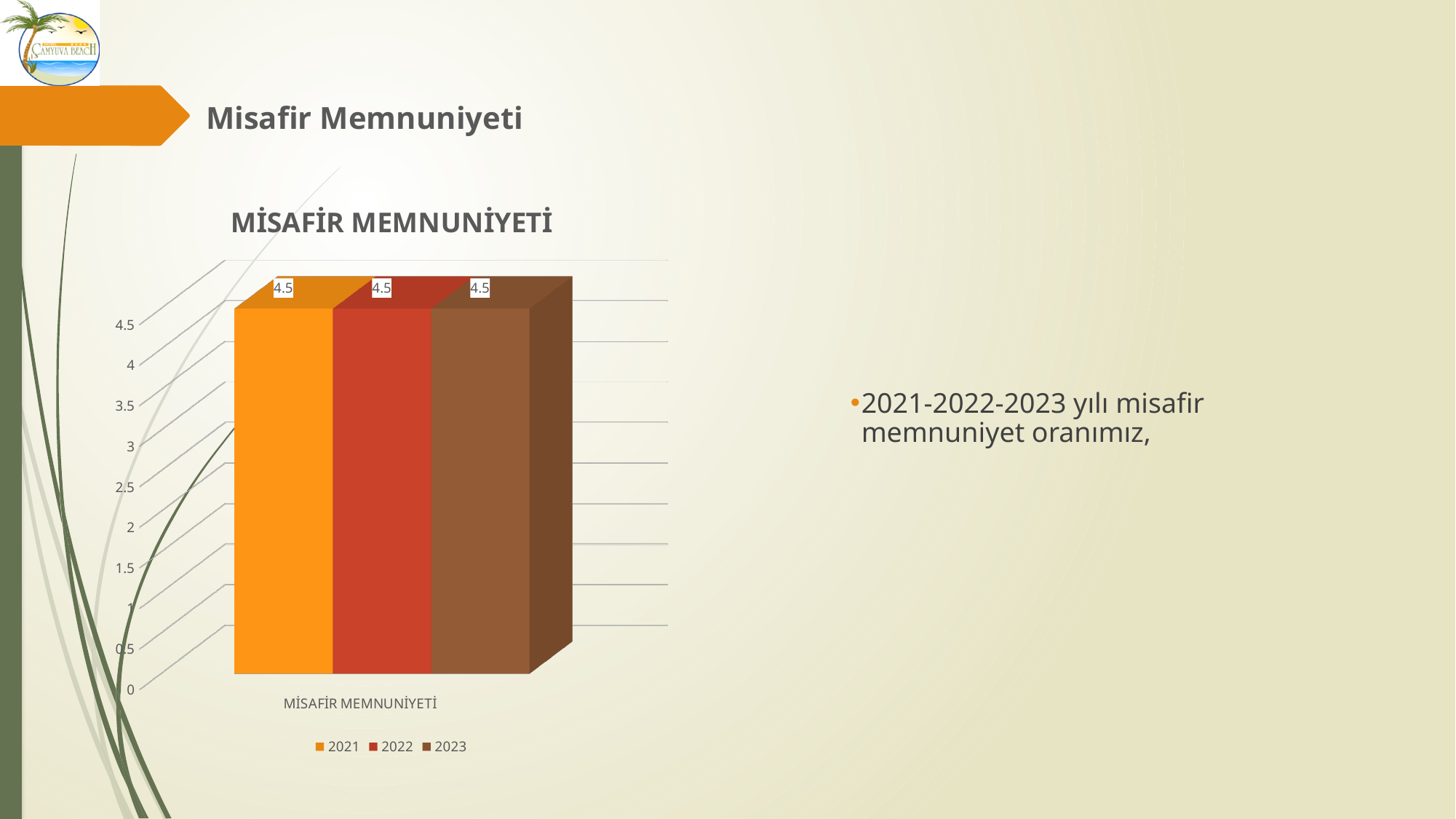
How many categories are shown on the x axis of the chart? 1 What kind of chart is shown on the slide? Bar chart Is the value for 2022 greater or less than 4? greater What is the value for the 2021 series in the chart? 4.5 How many series does the legend list? 3 What is the difference between the values for 2023 and 2021? 0 What is the title of the chart? MİSAFİR MEMNUNİYETİ Do the values change from 2021 to 2023, or stay the same? Stay the same Which series is shown in orange in the legend? 2021 What is the value for the 2023 series in the chart? 4.5 Is the value for 2023 greater or less than 3? greater What is the value for the 2022 series in the chart? 4.5